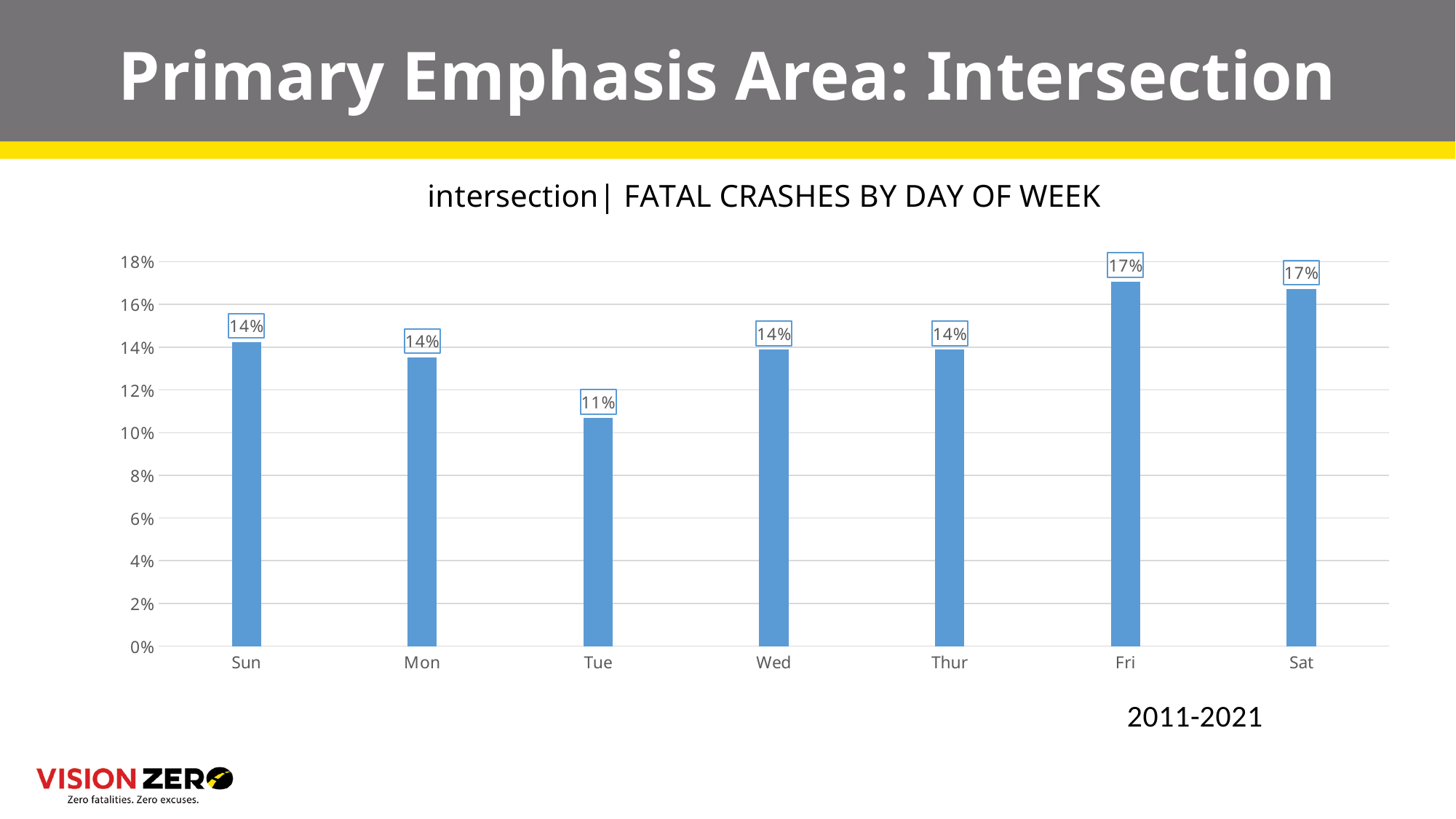
Which is larger, the value for Fri or the value for Mon? Fri What kind of chart is shown on the slide? bar chart What is the value for Sat? 17% How many days of the week are shown on the x axis? 7 What is the difference between the values for Sun and Tue? 3% What is the value for Fri? 17% What is the value for Wed? 14% Is the value for Tue greater or less than 12%? less Which day has the lowest share of fatal crashes? Tue What is the value for Tue? 11% What is the difference between the values for Fri and Tue? 6% What is the title of the chart? intersection| FATAL CRASHES BY DAY OF WEEK